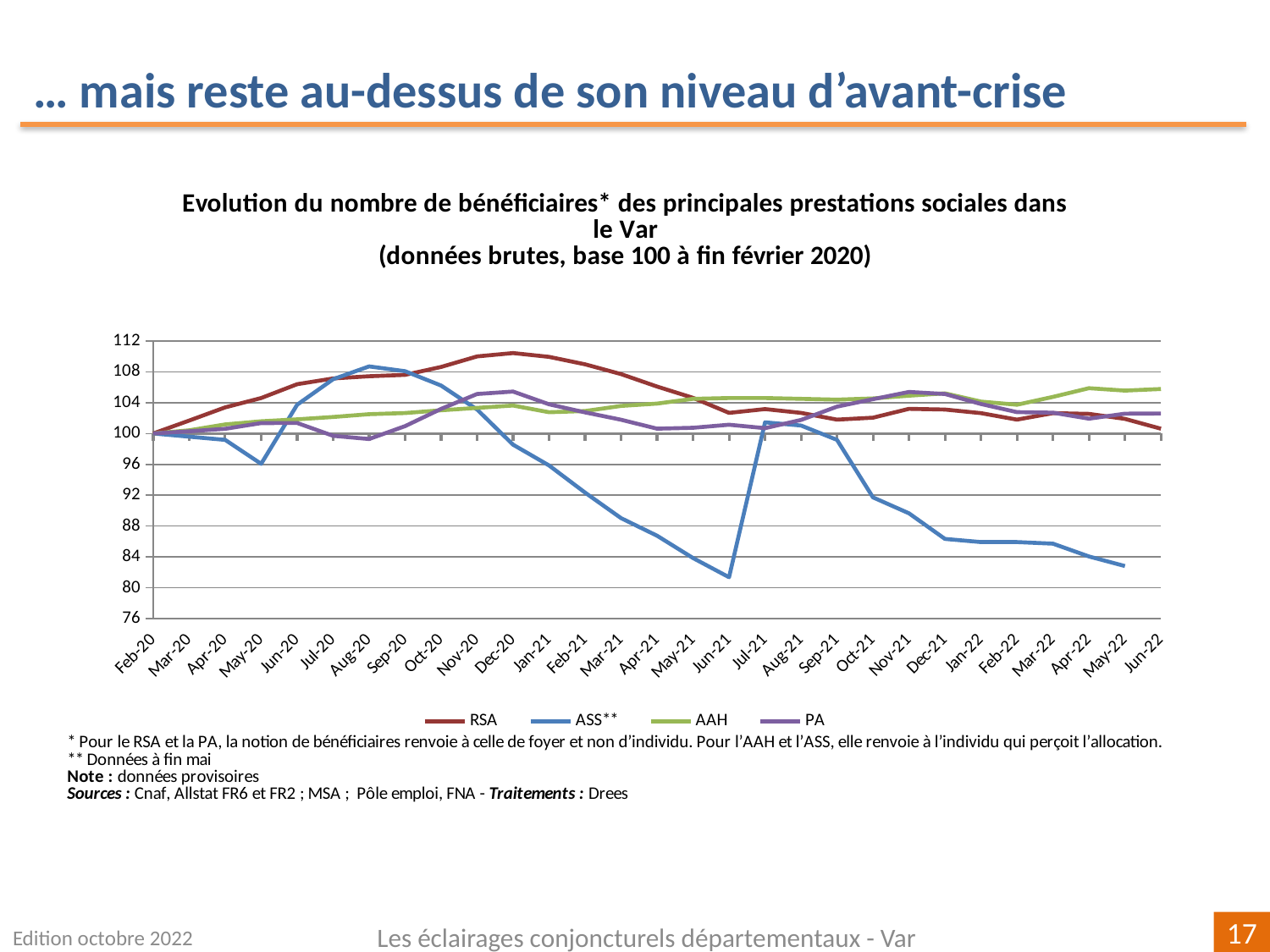
How many months are shown along the x axis, from Feb-20 to Jun-22? 29 Is the value for ASS** in Jun-21 greater or less than 84? less Is the value for ASS** in Mar-21 greater or less than 92? less How many series does the legend list? 4 Which series has the lowest value in Jun-21? ASS** Does the ASS** series rise or fall between Aug-20 and Jun-21? fall What is the base period used for the index of 100 according to the chart title? fin février 2020 Is the value for AAH in Apr-22 greater or less than 104? greater What kind of chart is shown on the slide? line chart Which series has the highest value in Dec-20? RSA In Aug-20, which is larger, the value for ASS** or the value for AAH? ASS**